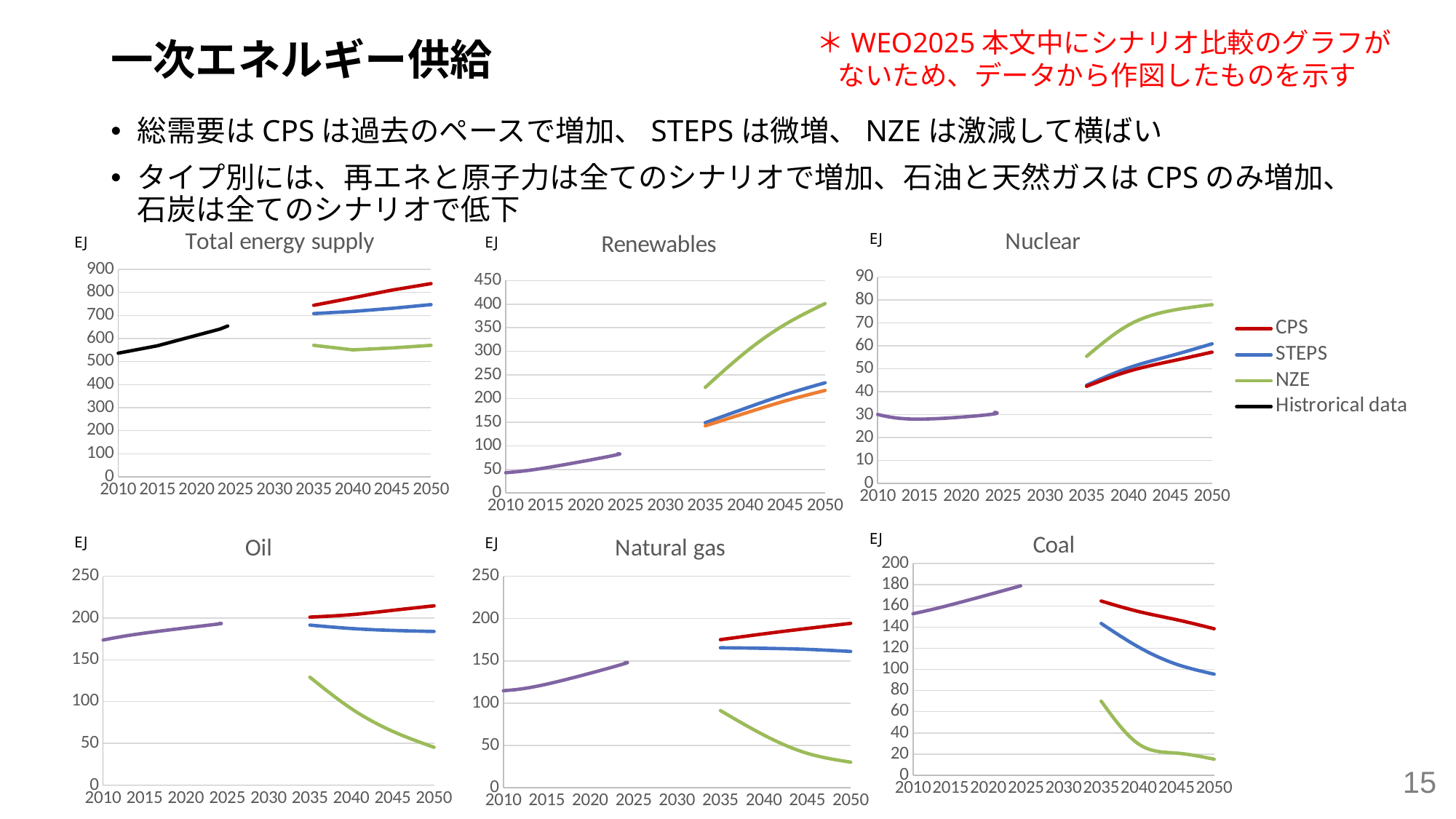
In the Oil chart, does the CPS line rise or fall from 2035 to 2050? rise How many series does the legend on the slide list? 4 In the Coal chart, does the NZE line rise or fall from 2035 to 2050? fall In the Renewables chart, does the NZE line rise or fall from 2035 to 2050? rise What kind of chart is the Total energy supply chart? line chart In the Total energy supply chart, is the CPS value in 2050 greater or less than 800? greater In the Natural gas chart, which is larger in 2050, STEPS or NZE? STEPS In the Renewables chart, is the NZE value in 2050 greater or less than 350? greater In the Oil chart, which is larger in 2050, CPS or NZE? CPS In the Nuclear chart, is the NZE value in 2050 greater or less than 70? greater How many charts are shown on the slide? 6 What unit is shown on the vertical axis of the charts? EJ